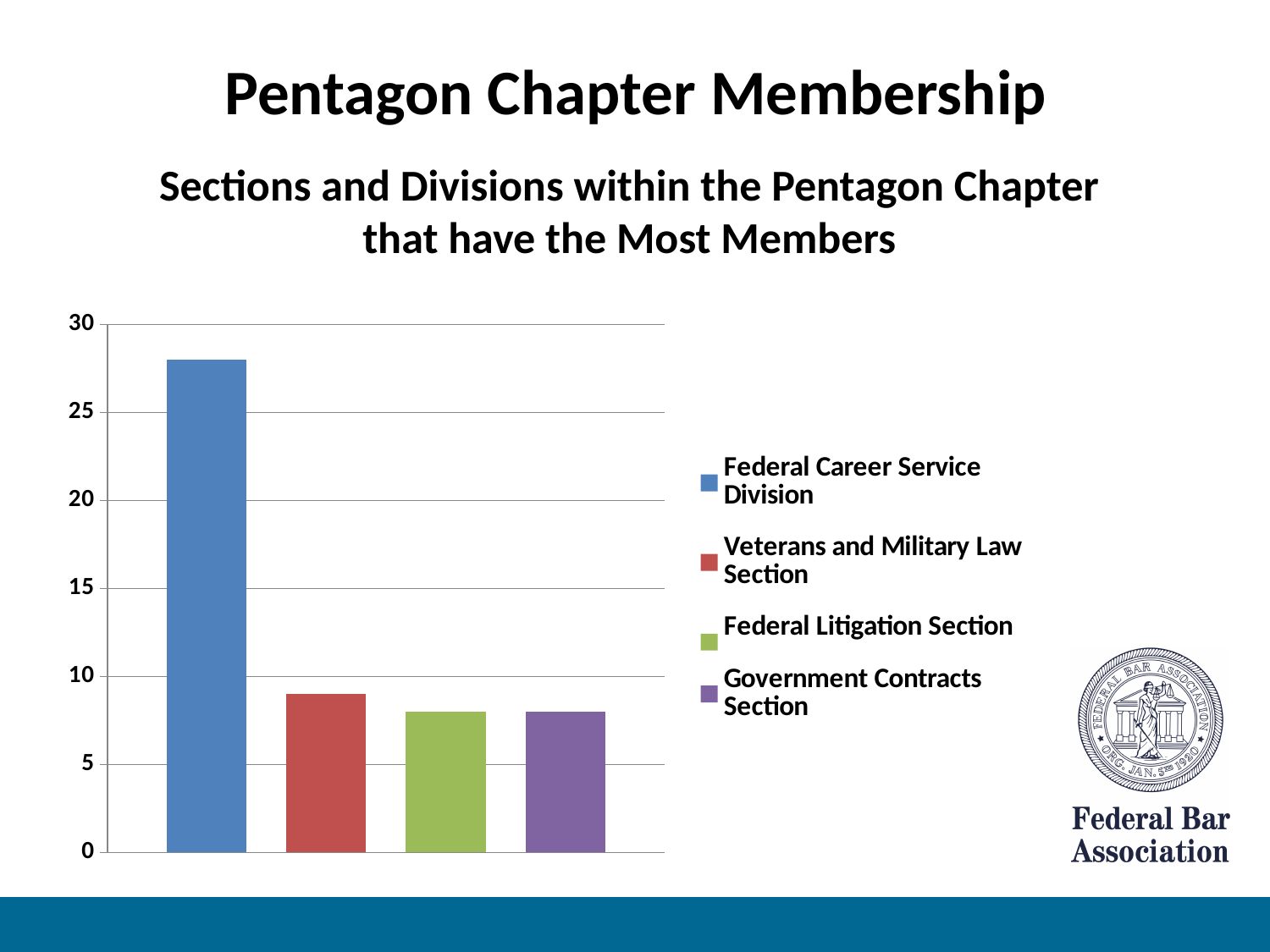
What kind of chart is shown on the slide? Bar chart What is the title of the chart on the slide? Sections and Divisions within the Pentagon Chapter that have the Most Members Which has more members, the Federal Career Service Division or the Veterans and Military Law Section? Federal Career Service Division What colour is the bar for the Federal Litigation Section? Green Is the value for the Government Contracts Section greater or less than 5? greater Is the value for the Federal Litigation Section greater or less than 10? less Which section or division has the highest number of members in the chart? Federal Career Service Division Is the value for the Veterans and Military Law Section greater or less than 10? less How many bars are plotted in the chart? 4 How many entries does the chart's legend list? 4 Which has more members, the Veterans and Military Law Section or the Federal Litigation Section? Veterans and Military Law Section